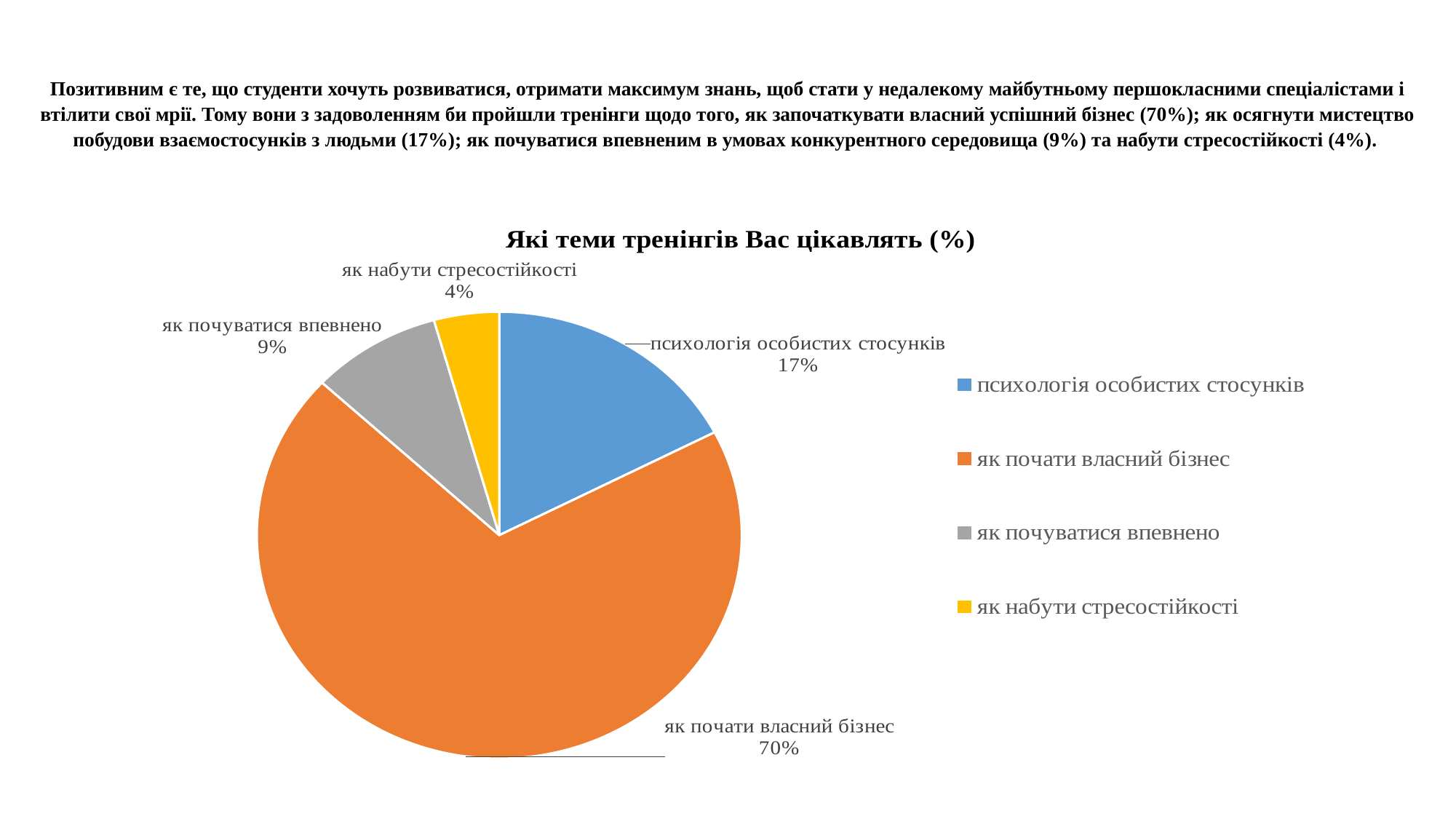
What is the value shown for "як набути стресостійкості"? 4% What is the difference between the shares for "як почати власний бізнес" and "психологія особистих стосунків"? 53% What kind of chart is shown on the slide? pie chart Which category has the largest slice of the pie? як почати власний бізнес How many categories does the pie chart have? 4 What is the value shown for "психологія особистих стосунків"? 17% What colour is the slice for "як почати власний бізнес"? orange Which is larger: the share for "як почуватися впевнено" or for "як набути стресостійкості"? як почуватися впевнено What share of the pie does "як почати власний бізнес" take? 70% Which category has the smallest slice of the pie? як набути стресостійкості What is the value shown for "як почуватися впевнено"? 9% What is the title of the chart? Які теми тренінгів Вас цікавлять (%)